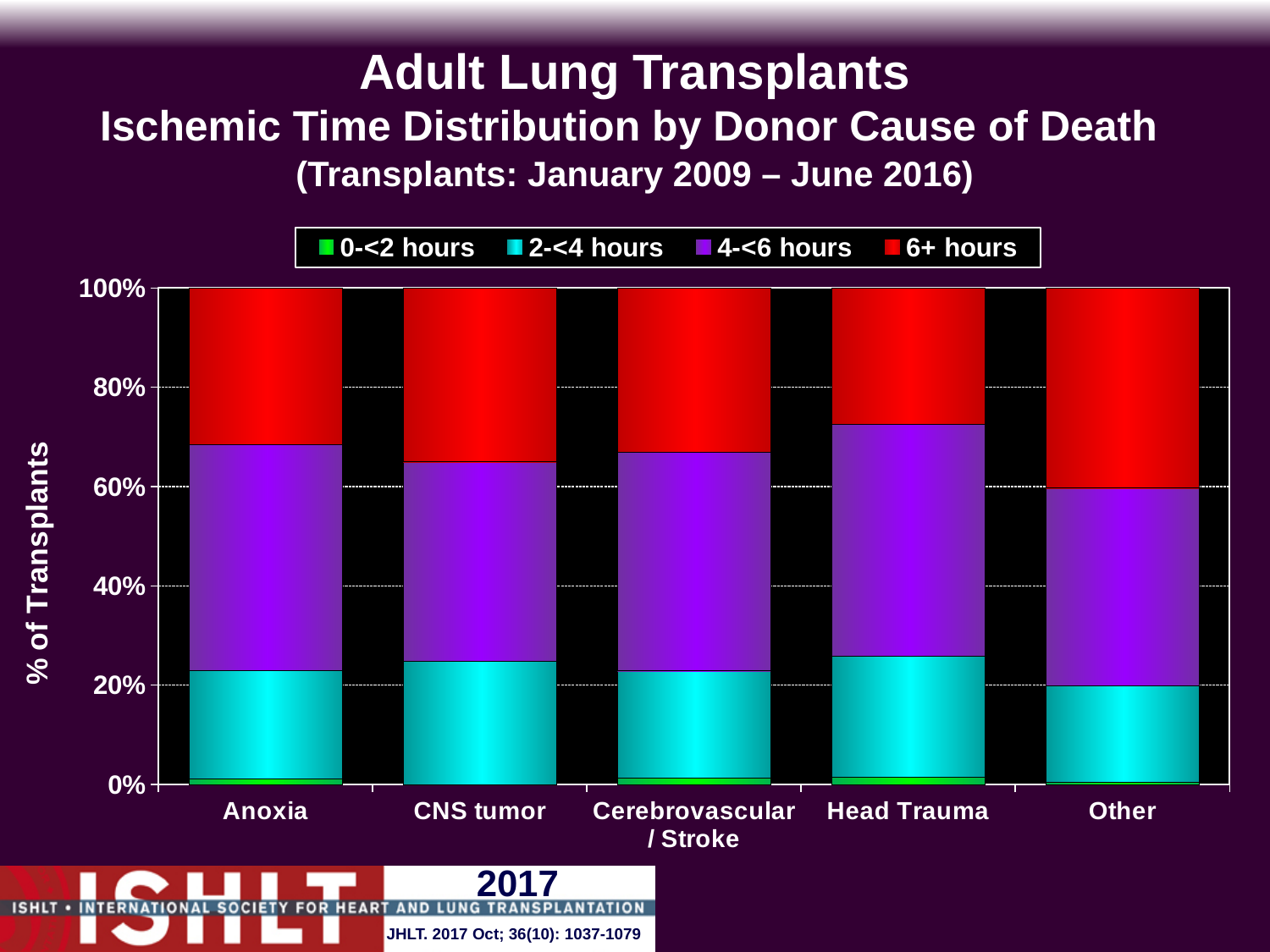
Is the 6+ hours share for Other larger or smaller than the 6+ hours share for Head Trauma? larger Is the 6+ hours share for Other greater or less than 20%? greater How many series does the legend list? 4 Which donor cause of death has the largest 6+ hours share? Other Is the 4-<6 hours share for Head Trauma greater or less than 40%? greater Which colour represents the 6+ hours series in the legend? Red What kind of chart is shown on the slide? Stacked bar chart How many donor cause of death categories are shown on the x axis? 5 Which donor cause of death has the smallest 6+ hours share? Head Trauma What is the label of the y axis? % of Transplants What is the total of the stacked bar for Anoxia? 100% Is the 0-<2 hours share for Anoxia greater or less than 20%? less